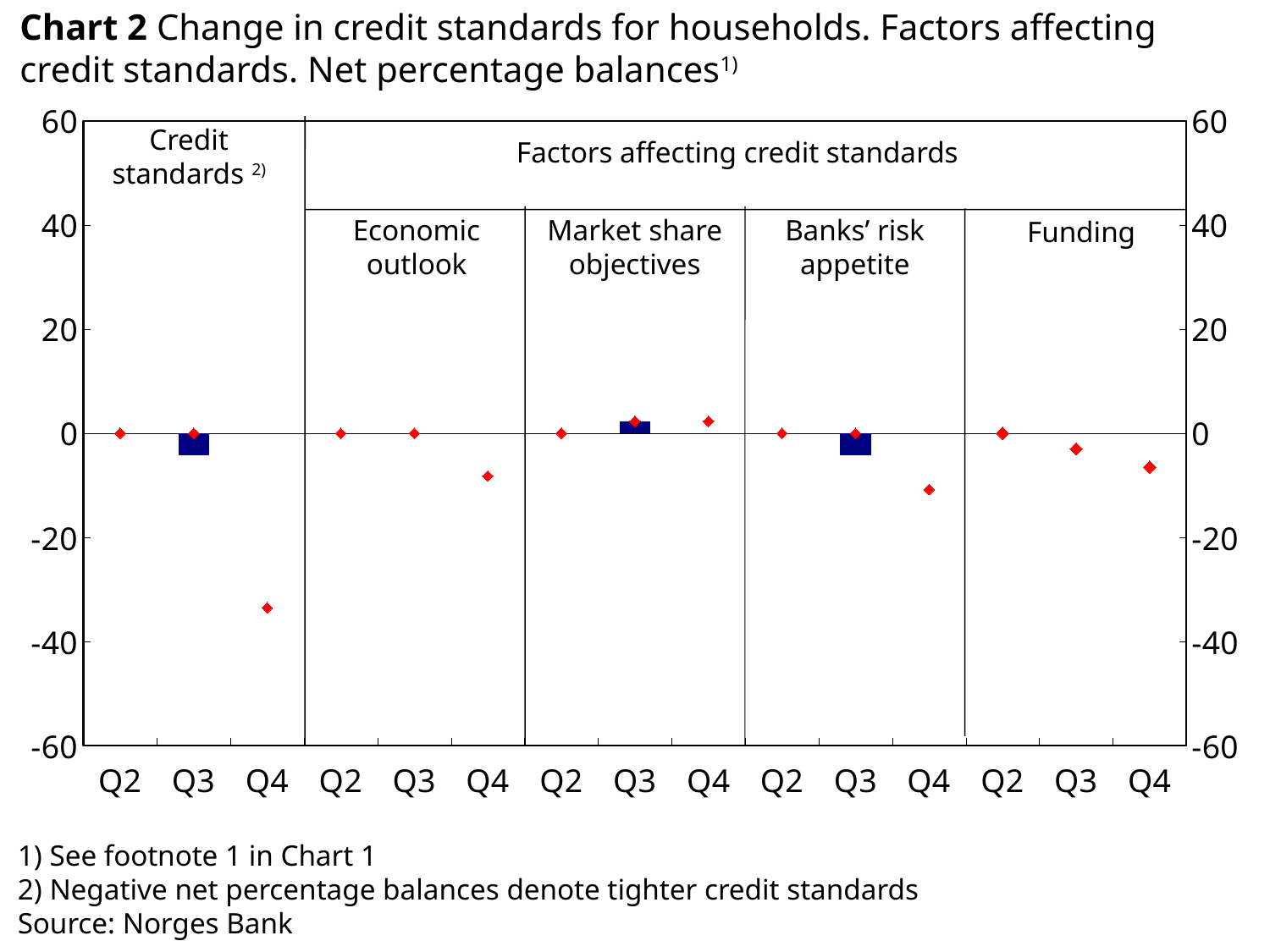
In the Credit standards panel, is the Q4 value greater or less than -20? less How many factors are listed under 'Factors affecting credit standards'? 4 In the Credit standards panel, do the red markers rise or fall from Q2 to Q4? fall Which is lower: the Q4 value in the Credit standards panel or the Q4 value in the Funding panel? Credit standards Q4 In the Economic outlook panel, is the Q4 value greater or less than 0? less What is the source given for the chart? Norges Bank Which panel contains the lowest red marker on the chart? Credit standards In the Market share objectives panel, is the Q4 value greater or less than 0? greater Which is lower: the Q4 value in the Credit standards panel or the Q4 value in the Banks' risk appetite panel? Credit standards Q4 In the Funding panel, do the red markers rise or fall from Q2 to Q4? fall How many quarters are shown in each panel of the chart? 3